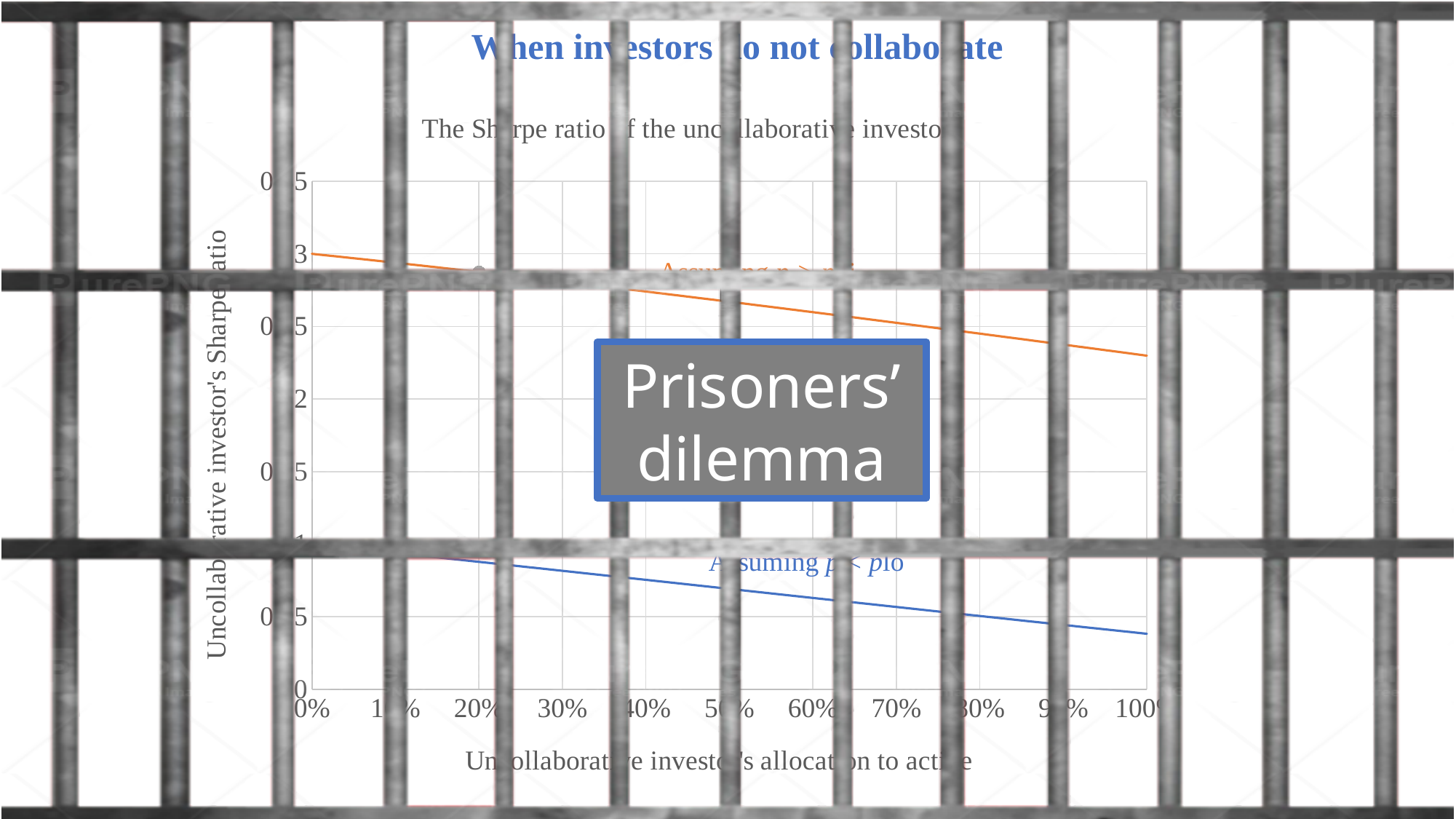
How many lines (series) are plotted on the chart? 2 Is the value of the blue line at 100% allocation to active greater or less than 1? less Is the value of the blue line at 60% allocation to active greater or less than 1? less Does the blue line (Assuming p < plo) rise or fall as the allocation to active increases along the x axis? fall Does the orange line (Assuming p > plo) rise or fall as the allocation to active increases from 0% to 100%? fall What is the label of the y axis of the chart? Uncollaborative investor's Sharpe ratio What is the label of the x axis of the chart? Uncollaborative investor's allocation to active Is the value of the orange line at 100% allocation to active greater or less than 2.5? less How many tick labels are shown on the x axis, from 0% to 100%? 11 What kind of chart is shown on the slide? line chart At 100% allocation to active, which line has the higher Sharpe ratio, the orange line or the blue line? orange line